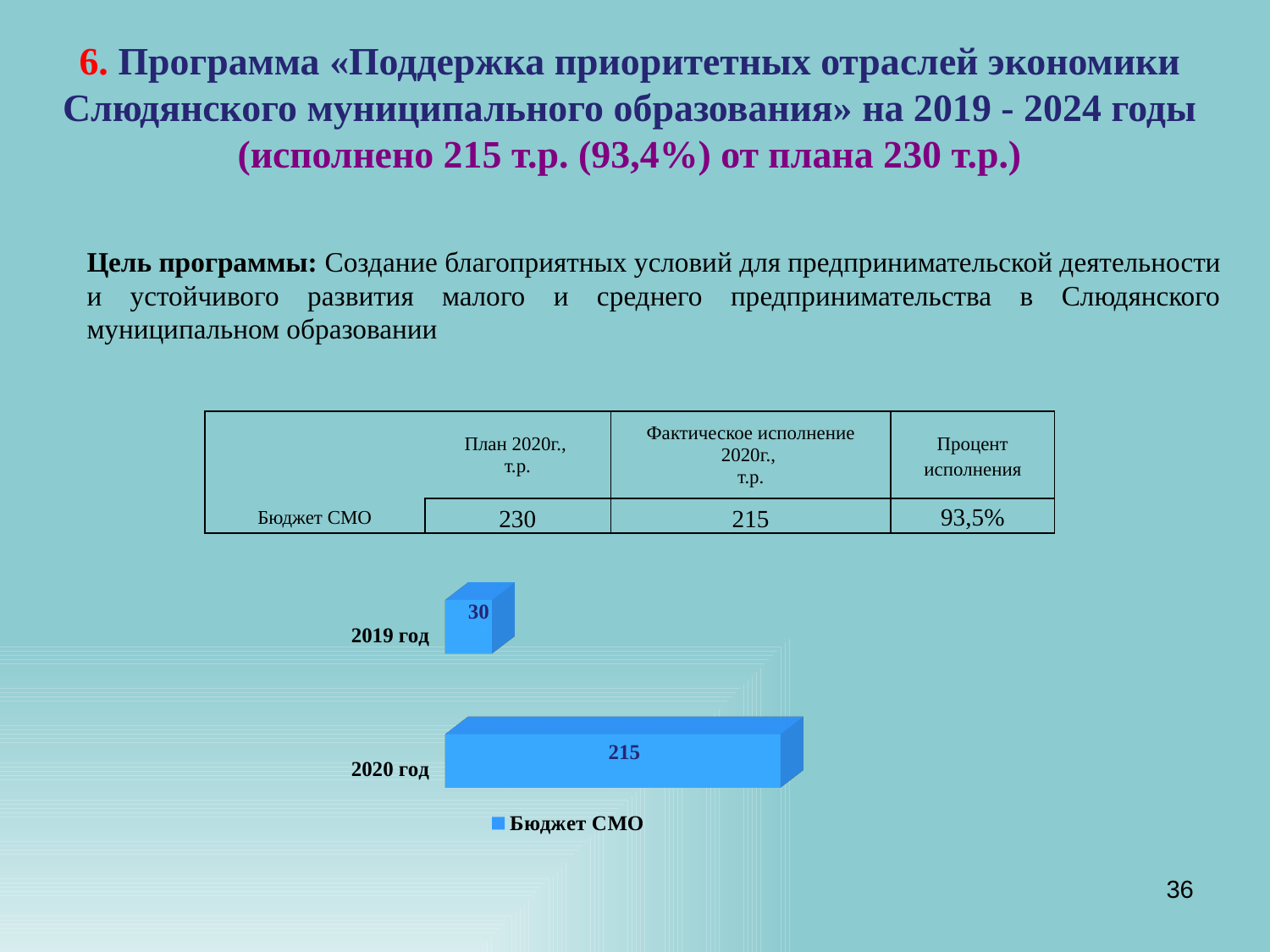
What kind of chart is shown on the slide? bar chart How many categories are shown in the chart? 2 Do the values rise or fall from 2019 год to 2020 год? rise What is the name of the series listed in the chart legend? Бюджет СМО How many series does the chart legend list? 1 What is the value for 2020 год in the chart? 215 What is the value for 2019 год in the chart? 30 What is the difference between the values for 2020 год and 2019 год? 185 Which is larger, the value for 2019 год or the value for 2020 год? 2020 год Which category has the lowest value in the chart? 2019 год What colour are the bars in the chart? blue Which category has the highest value in the chart? 2020 год